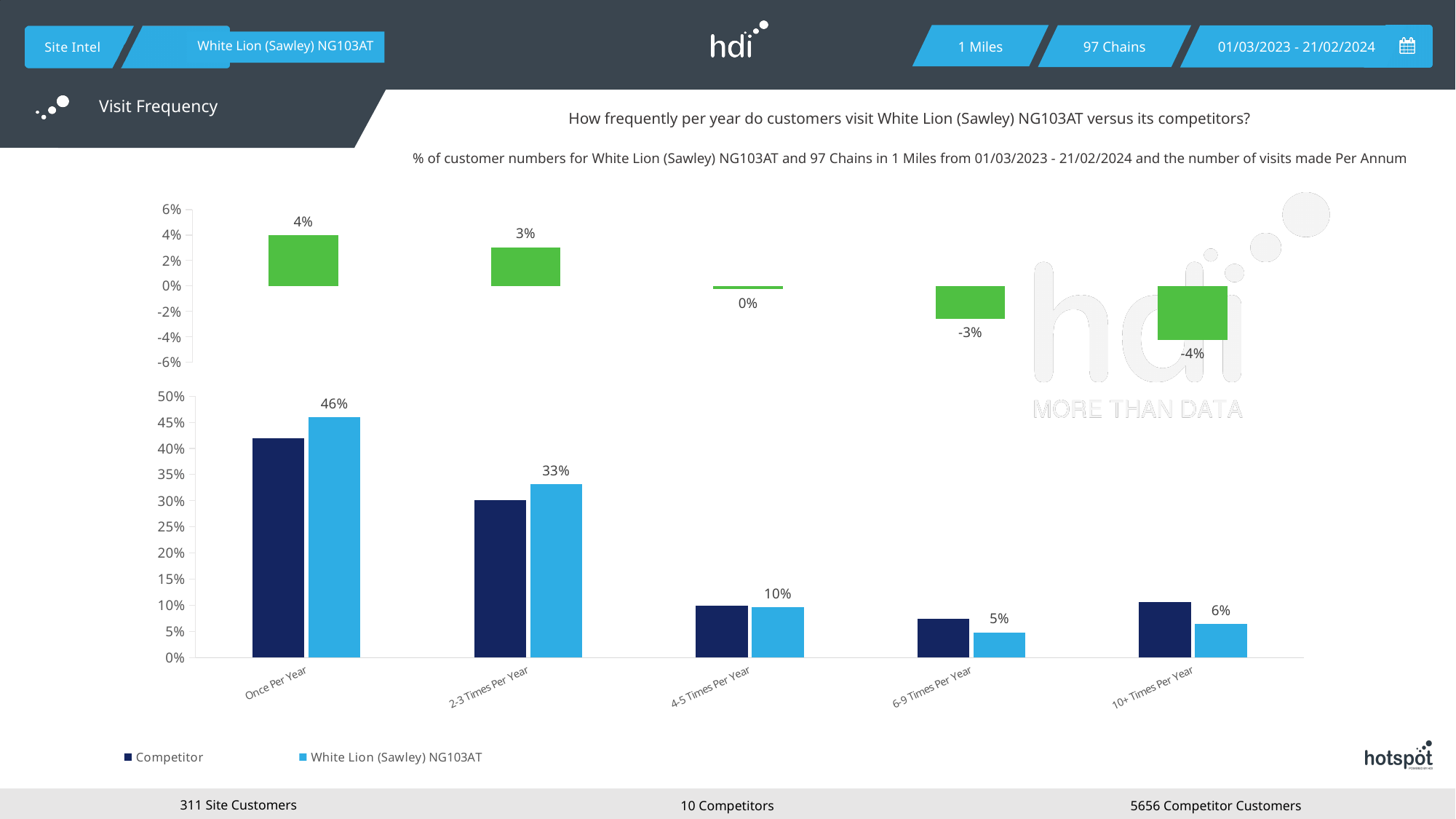
In the bottom chart, what is the value for White Lion (Sawley) NG103AT for 2-3 Times Per Year? 33% In the bottom chart, which is larger for 10+ Times Per Year: Competitor or White Lion (Sawley) NG103AT? Competitor In the bottom chart, what is the value for White Lion (Sawley) NG103AT for Once Per Year? 46% How many categories are shown on the x axis of the bottom chart? 5 In the bottom chart, what is the value for White Lion (Sawley) NG103AT for 6-9 Times Per Year? 5% How many series does the legend of the bottom chart list? 2 In the top chart, what is the value shown for Once Per Year? 4% In the bottom chart, which category has the highest value for White Lion (Sawley) NG103AT? Once Per Year In the bottom chart, which category has the lowest value for White Lion (Sawley) NG103AT? 6-9 Times Per Year In the bottom chart, is the Competitor value for Once Per Year greater or less than 40%? greater In the top chart, what is the value shown for 10+ Times Per Year? -4% In the bottom chart, what is the difference between the White Lion (Sawley) NG103AT values for Once Per Year and 2-3 Times Per Year? 13%